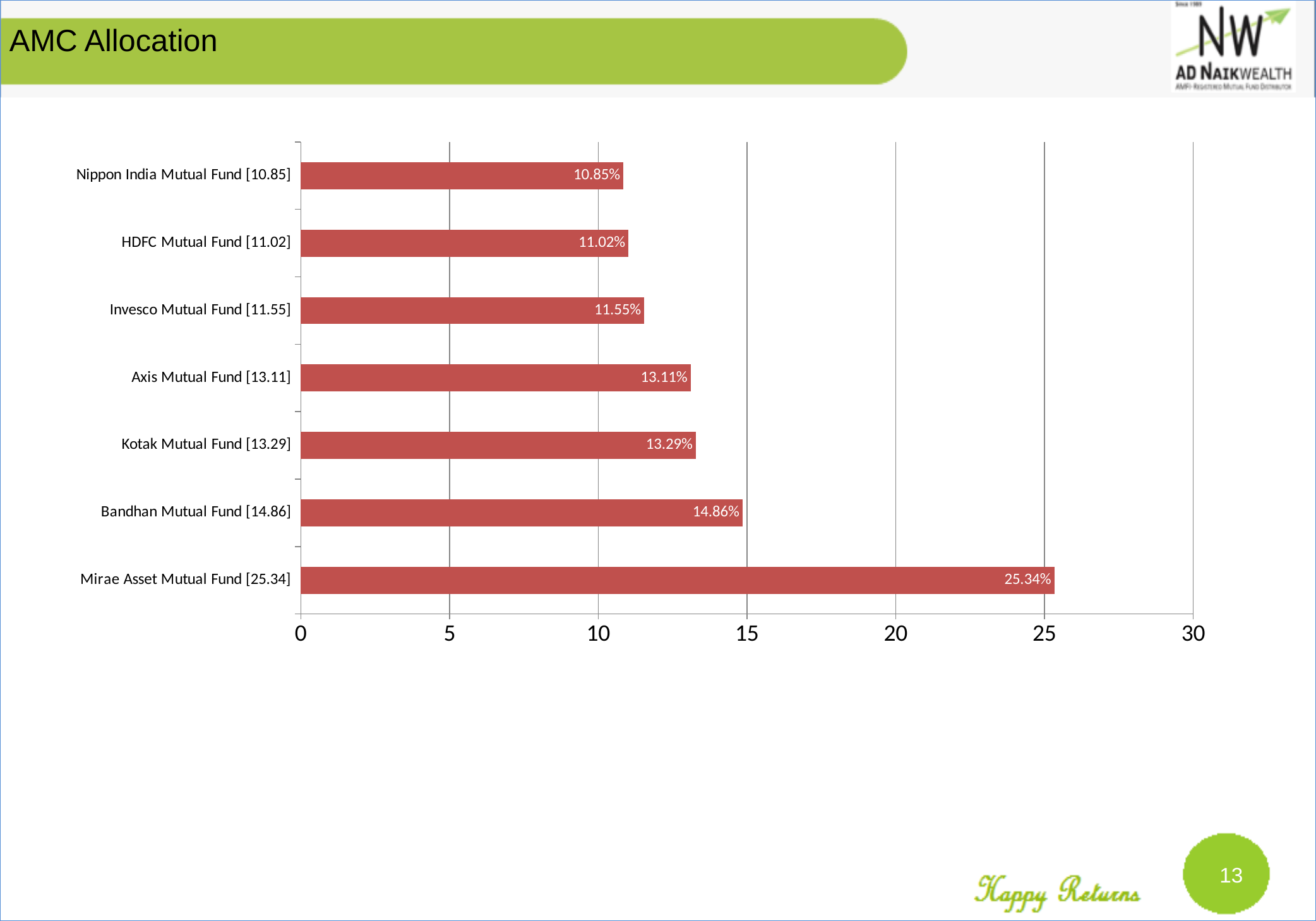
What is the value for Nippon India Mutual Fund? 10.85% Is the value for Bandhan Mutual Fund greater or less than 15? less How many funds are shown in the chart? 7 What is the difference between the values for Invesco Mutual Fund and HDFC Mutual Fund? 0.53% What is the difference between the values for Mirae Asset Mutual Fund and Bandhan Mutual Fund? 10.48% Which fund has the lowest allocation? Nippon India Mutual Fund Which fund has the highest allocation? Mirae Asset Mutual Fund What is the value for Kotak Mutual Fund? 13.29% What kind of chart is shown on the slide? bar chart What is the value for Mirae Asset Mutual Fund? 25.34% What is the title of the slide? AMC Allocation Which is larger, the value for Axis Mutual Fund or the value for Bandhan Mutual Fund? Bandhan Mutual Fund